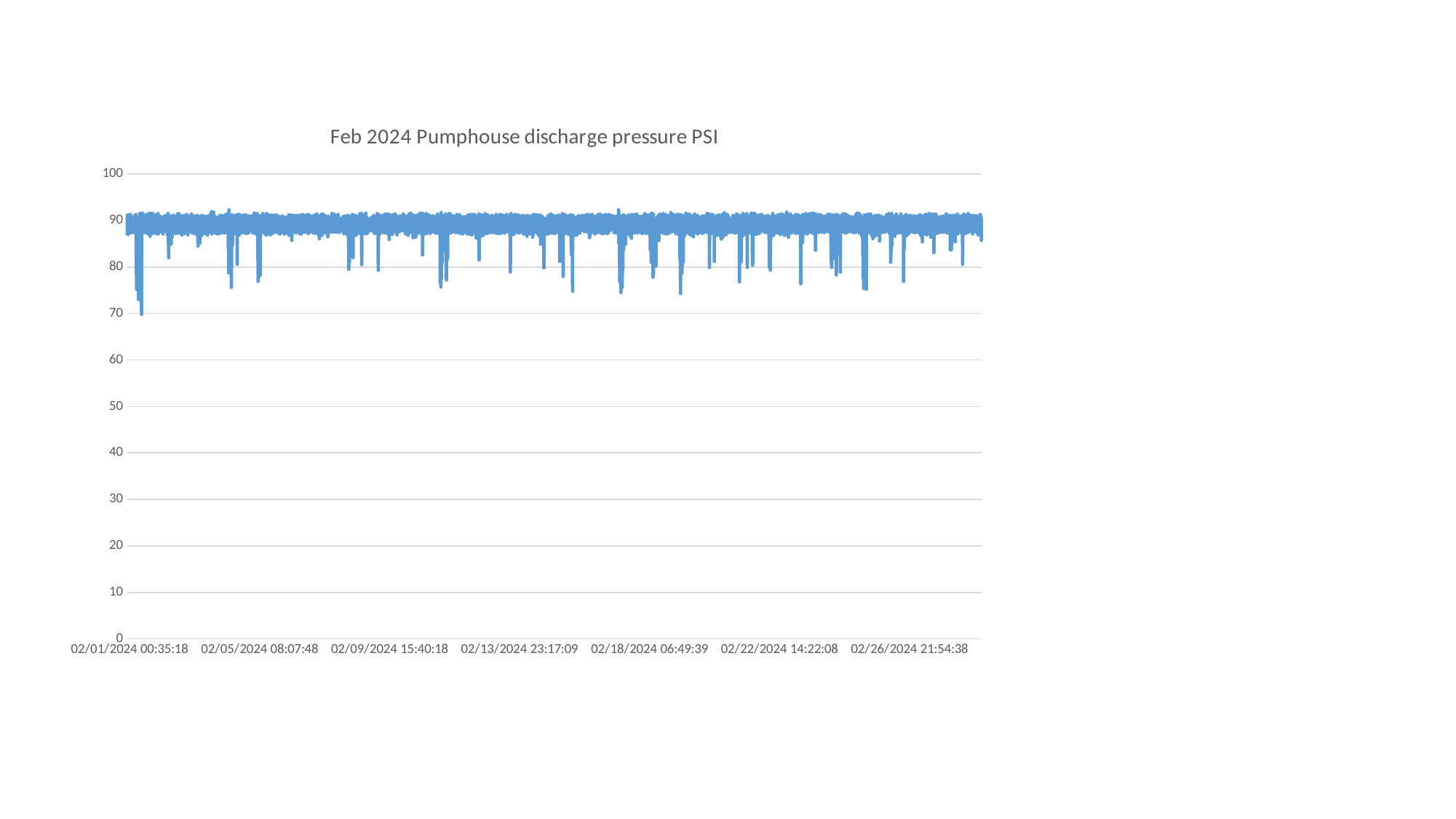
Overall, does the discharge pressure trend upward, downward, or stay roughly flat across February 2024? Roughly flat Is the value at 02/26/2024 21:54:38 greater or less than 70? greater What is the first date-time label on the horizontal axis? 02/01/2024 00:35:18 What is the title of the chart? Feb 2024 Pumphouse discharge pressure PSI Is the lowest dip in the discharge pressure greater or less than 60? greater How many date-time labels are shown along the horizontal axis? 7 Is the typical (baseline) discharge pressure value greater or less than 80? greater What kind of chart is shown on the slide? Line chart What is the highest value shown on the vertical axis? 100